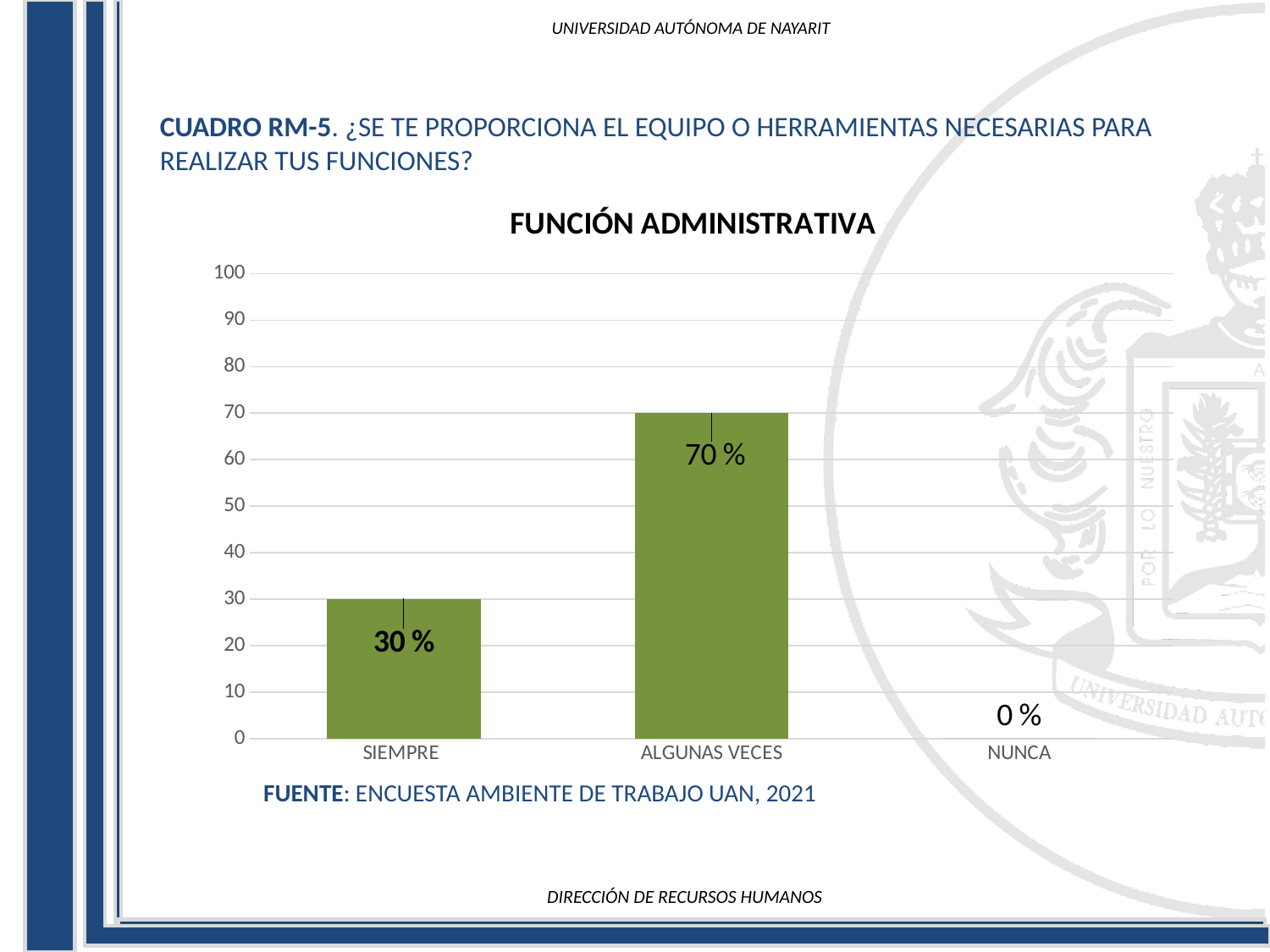
What is the value for SIEMPRE? 30 % What kind of chart is shown on the slide? bar chart How many categories are shown on the x axis? 3 What is the difference between the values for ALGUNAS VECES and SIEMPRE? 40 % What is the source cited below the chart? ENCUESTA AMBIENTE DE TRABAJO UAN, 2021 What is the title of the chart? FUNCIÓN ADMINISTRATIVA Which category has the highest value? ALGUNAS VECES What is the value for NUNCA? 0 % Which is larger, the value for SIEMPRE or the value for ALGUNAS VECES? ALGUNAS VECES What is the value for ALGUNAS VECES? 70 % Which category has the lowest value? NUNCA Is the value for ALGUNAS VECES greater or less than 50? greater